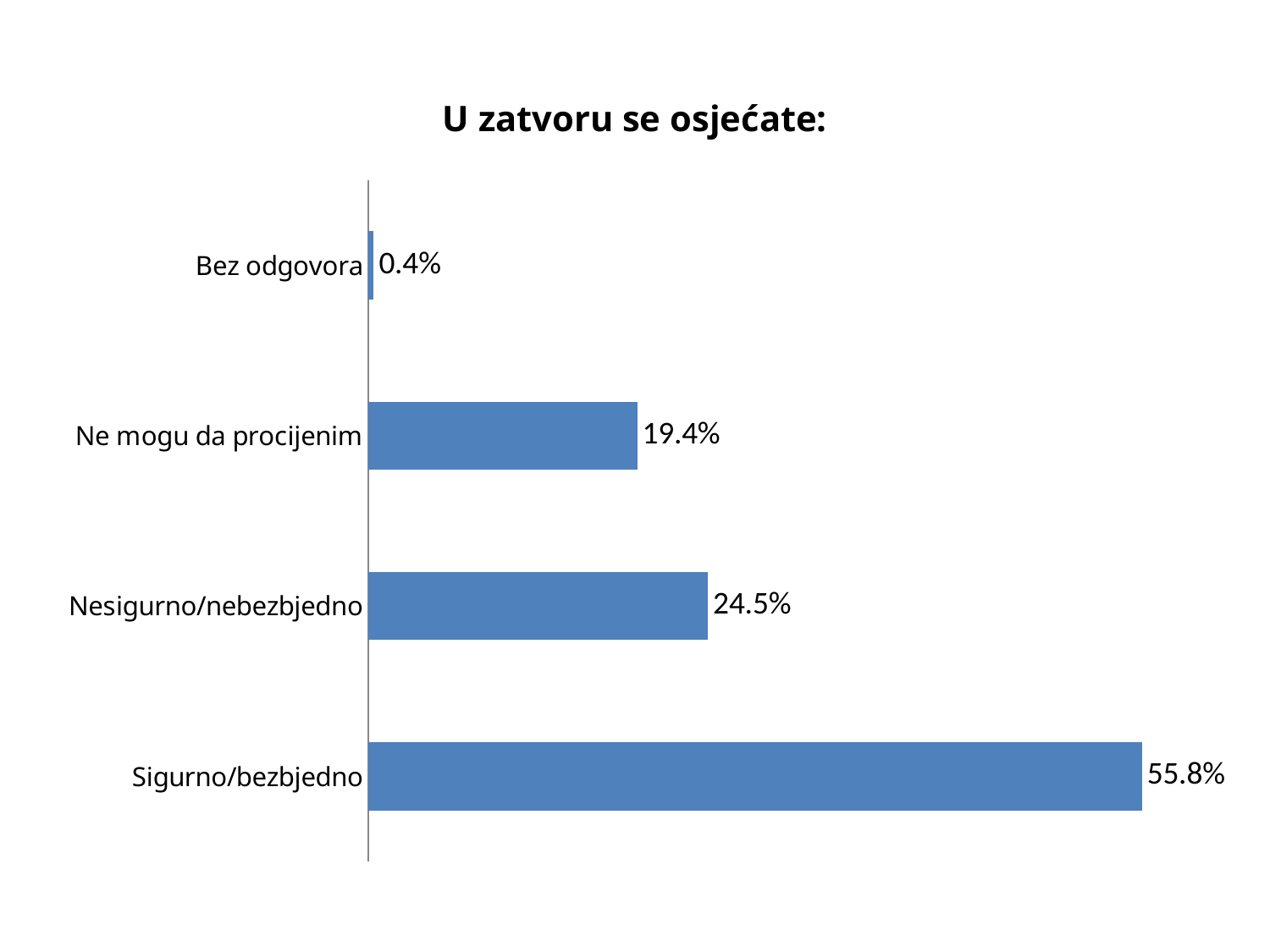
What is the value for Ne mogu da procijenim? 19.4% What is the title of the chart? U zatvoru se osjećate: Which category has the highest value? Sigurno/bezbjedno What is the difference between the values for Sigurno/bezbjedno and Nesigurno/nebezbjedno? 31.3% What is the value for Nesigurno/nebezbjedno? 24.5% Which is larger, the value for Nesigurno/nebezbjedno or the value for Ne mogu da procijenim? Nesigurno/nebezbjedno How many categories are shown in the chart? 4 What is the difference between the values for Nesigurno/nebezbjedno and Ne mogu da procijenim? 5.1% What is the value for Sigurno/bezbjedno? 55.8% What is the value for Bez odgovora? 0.4% What kind of chart is shown on the slide? Bar chart Which category has the lowest value? Bez odgovora